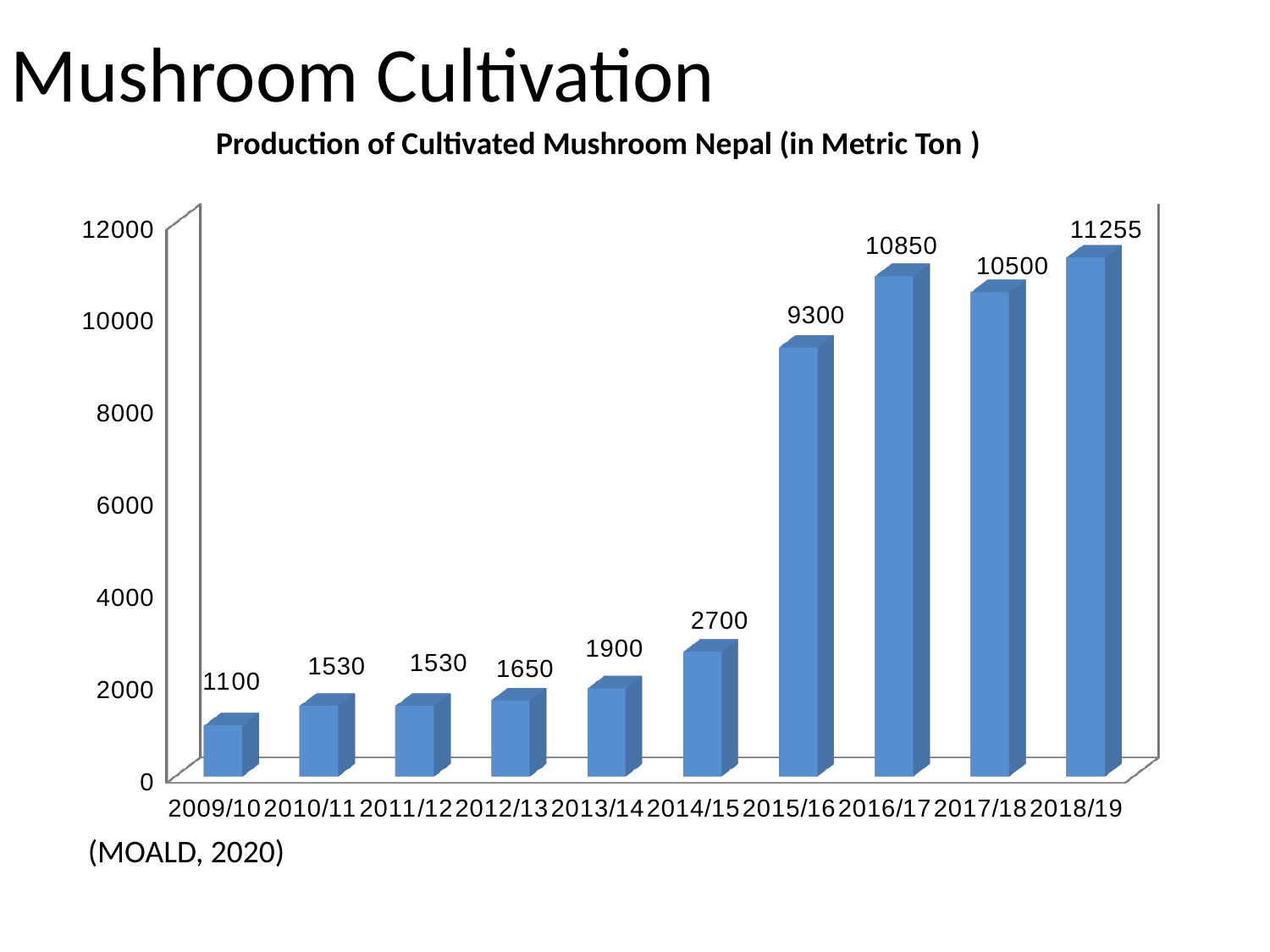
How many years are shown on the chart? 10 Do the production values generally rise or fall from 2009/10 to 2018/19? rise Which year has the lowest mushroom production? 2009/10 Is the value for 2014/15 greater or less than 4000? less What is the title of the chart? Production of Cultivated Mushroom Nepal (in Metric Ton ) Which year had higher production, 2016/17 or 2018/19? 2018/19 What is the difference in production between 2015/16 and 2014/15? 6600 Which year has the highest mushroom production? 2018/19 What value is shown for 2009/10? 1100 What was the production of cultivated mushroom in Nepal in 2015/16? 9300 What kind of chart is shown on the slide? bar chart What is the difference in production between 2016/17 and 2017/18? 350